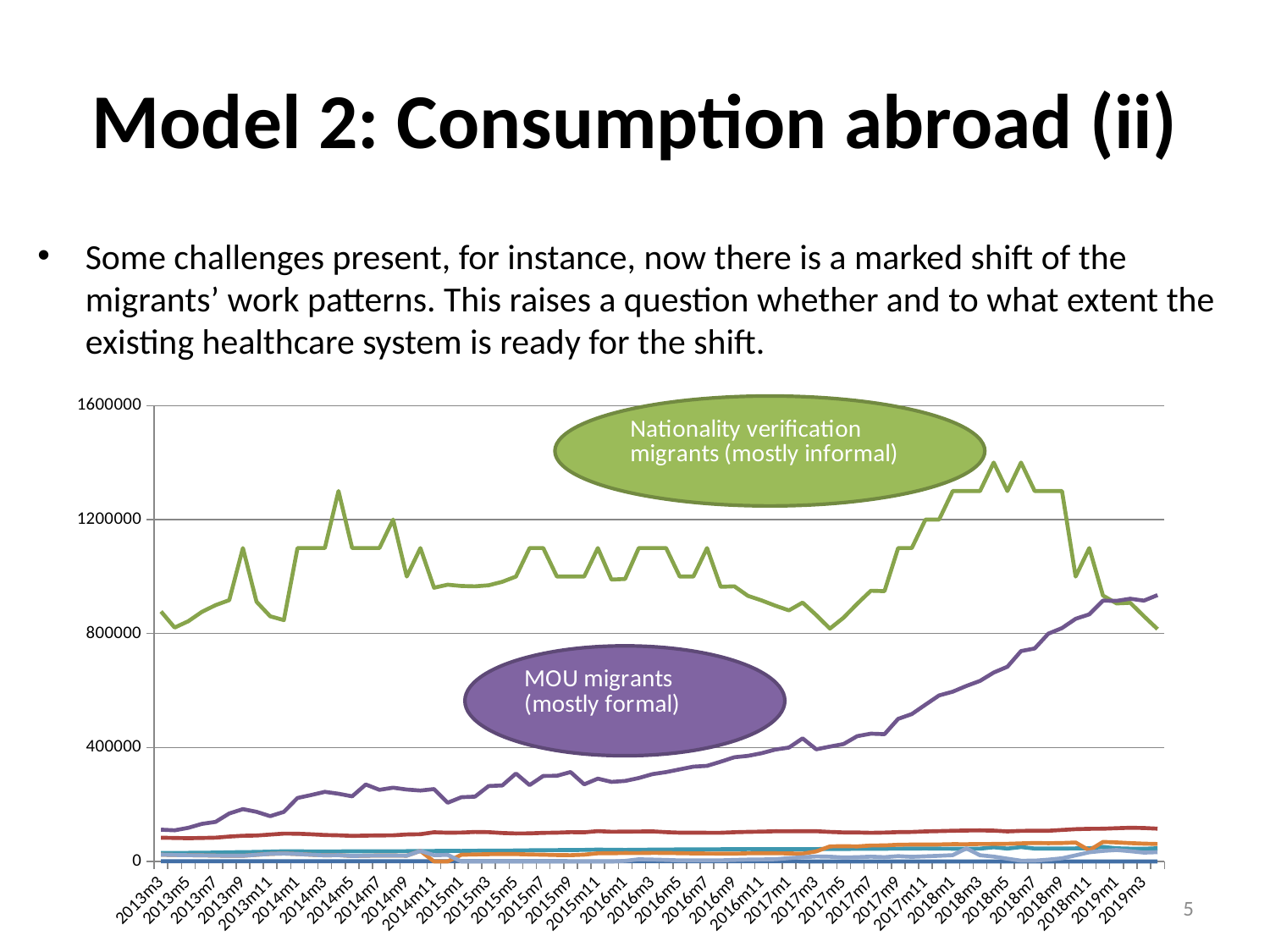
Which series does the green oval label identify? Nationality verification migrants (mostly informal) Is the value for Nationality verification migrants (mostly informal) at 2013m3 greater or less than 800000? greater Is the value for Nationality verification migrants (mostly informal) at 2018m5 greater or less than 1200000? greater What kind of chart is shown on the slide? line chart Does the MOU migrants (mostly formal) line rise or fall from 2013m3 to 2019m3? rise Is the value for MOU migrants (mostly formal) at 2019m3 greater or less than 800000? greater Which series does the purple oval label identify? MOU migrants (mostly formal) At 2013m3, which is larger: the Nationality verification migrants line or the MOU migrants line? Nationality verification migrants At 2016m1, which is larger: the Nationality verification migrants line or the MOU migrants line? Nationality verification migrants What is the highest value shown on the vertical axis? 1600000